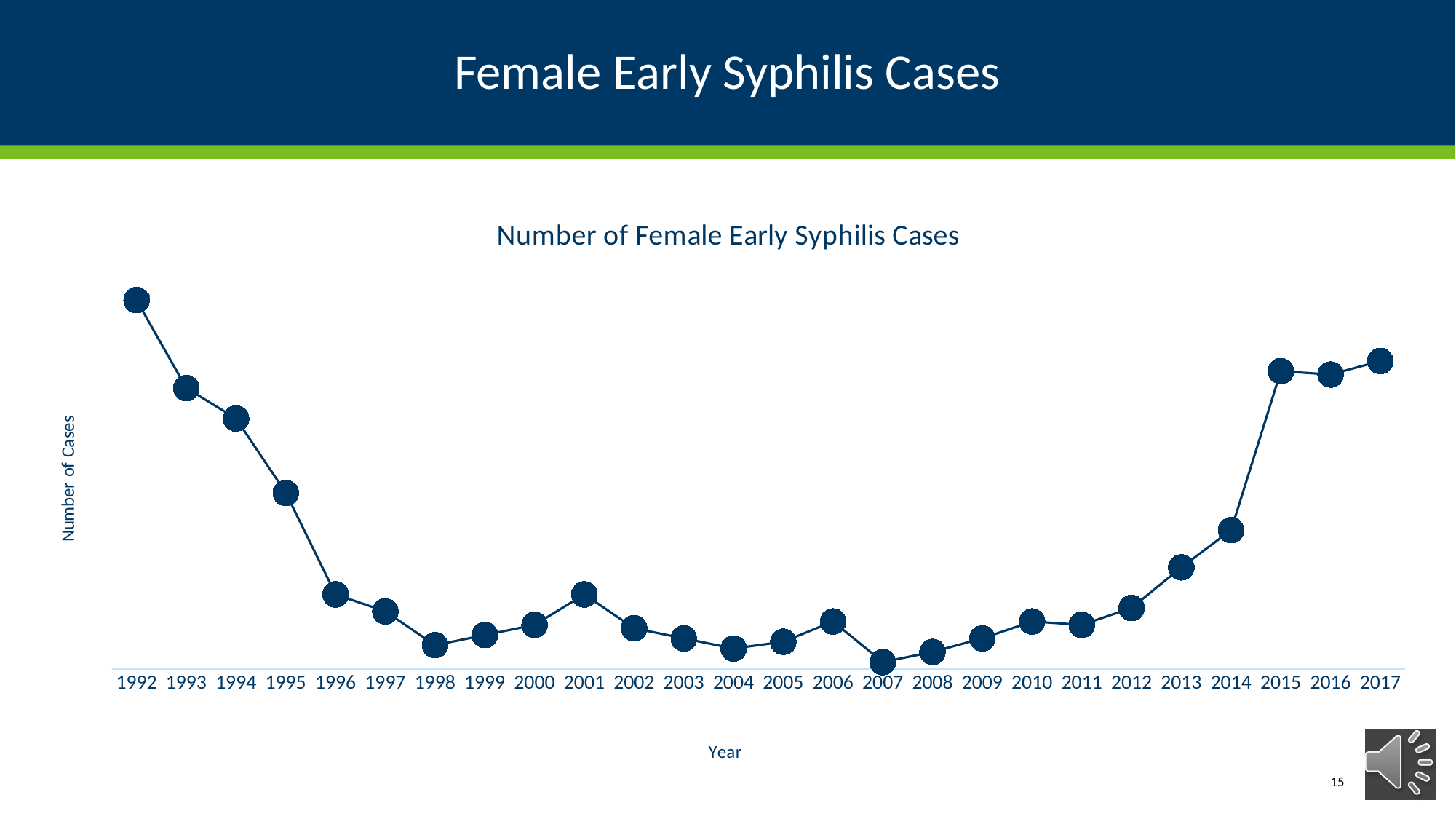
Which year has more female early syphilis cases, 2001 or 2007? 2001 What is the title of the chart? Number of Female Early Syphilis Cases Which year has the highest number of female early syphilis cases? 1992 Do the values rise or fall from 1992 to 1998? Fall Which year has the lowest number of female early syphilis cases? 2007 What kind of chart is shown on the slide? Line chart How many years are plotted on the chart? 26 Do the values rise or fall from 2008 to 2017? Rise Which year has more female early syphilis cases, 1995 or 2014? 1995 What is the label on the vertical axis of the chart? Number of Cases Which year has more female early syphilis cases, 1992 or 2017? 1992